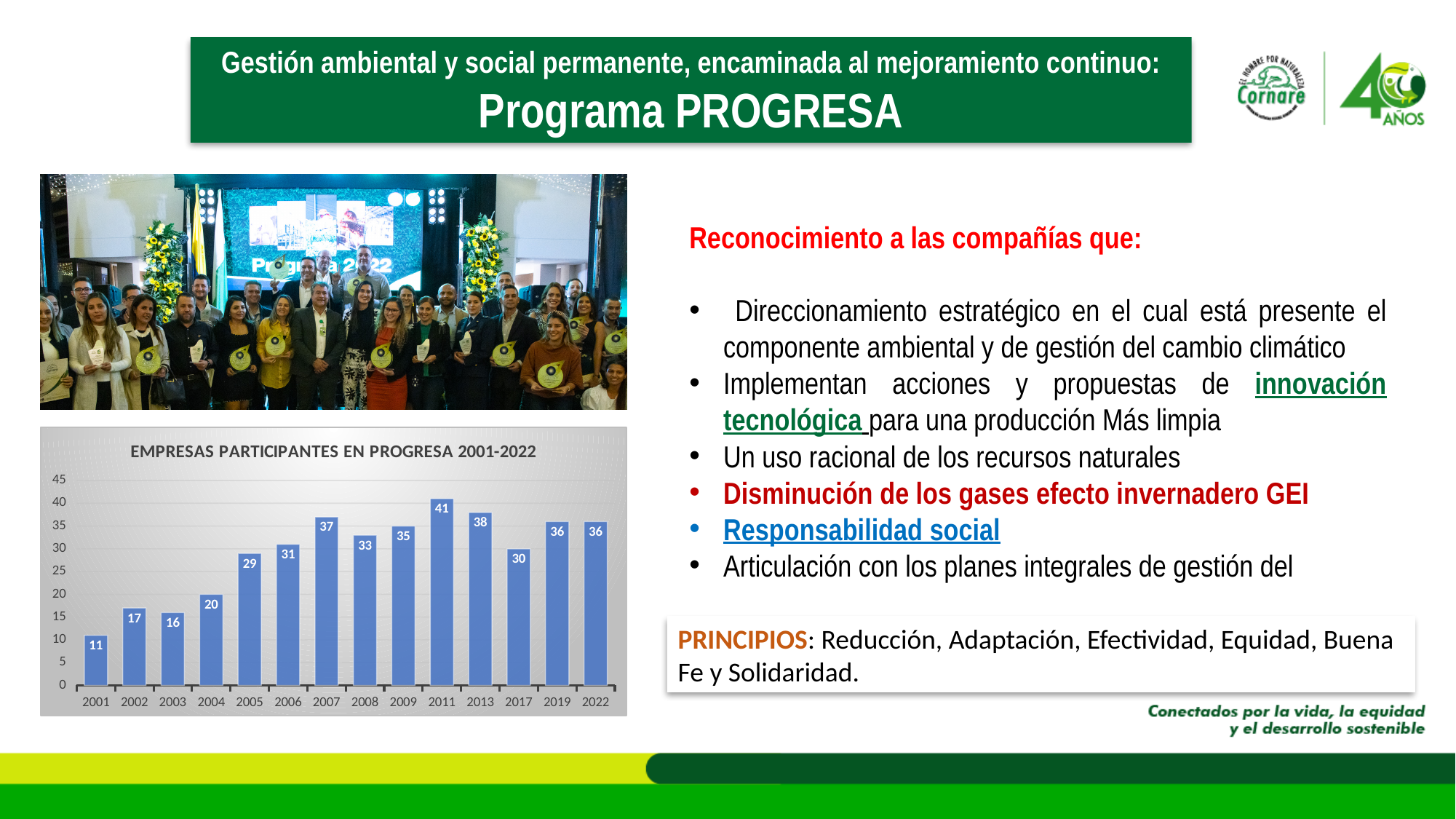
What is the value for 2011? 41 Which year has the lowest number of participating companies? 2001 How many participating companies are shown for 2001? 11 What is the difference between the values for 2013 and 2017? 8 What type of chart is shown on the slide? bar chart What is the title of the chart? EMPRESAS PARTICIPANTES EN PROGRESA 2001-2022 How many years (bars) are shown in the chart? 14 What is the value for 2017? 30 Do the values generally rise or fall from 2001 to 2011? rise Which year has the highest number of participating companies? 2011 Which is larger, the value for 2007 or the value for 2008? 2007 What is the difference between the values for 2011 and 2001? 30